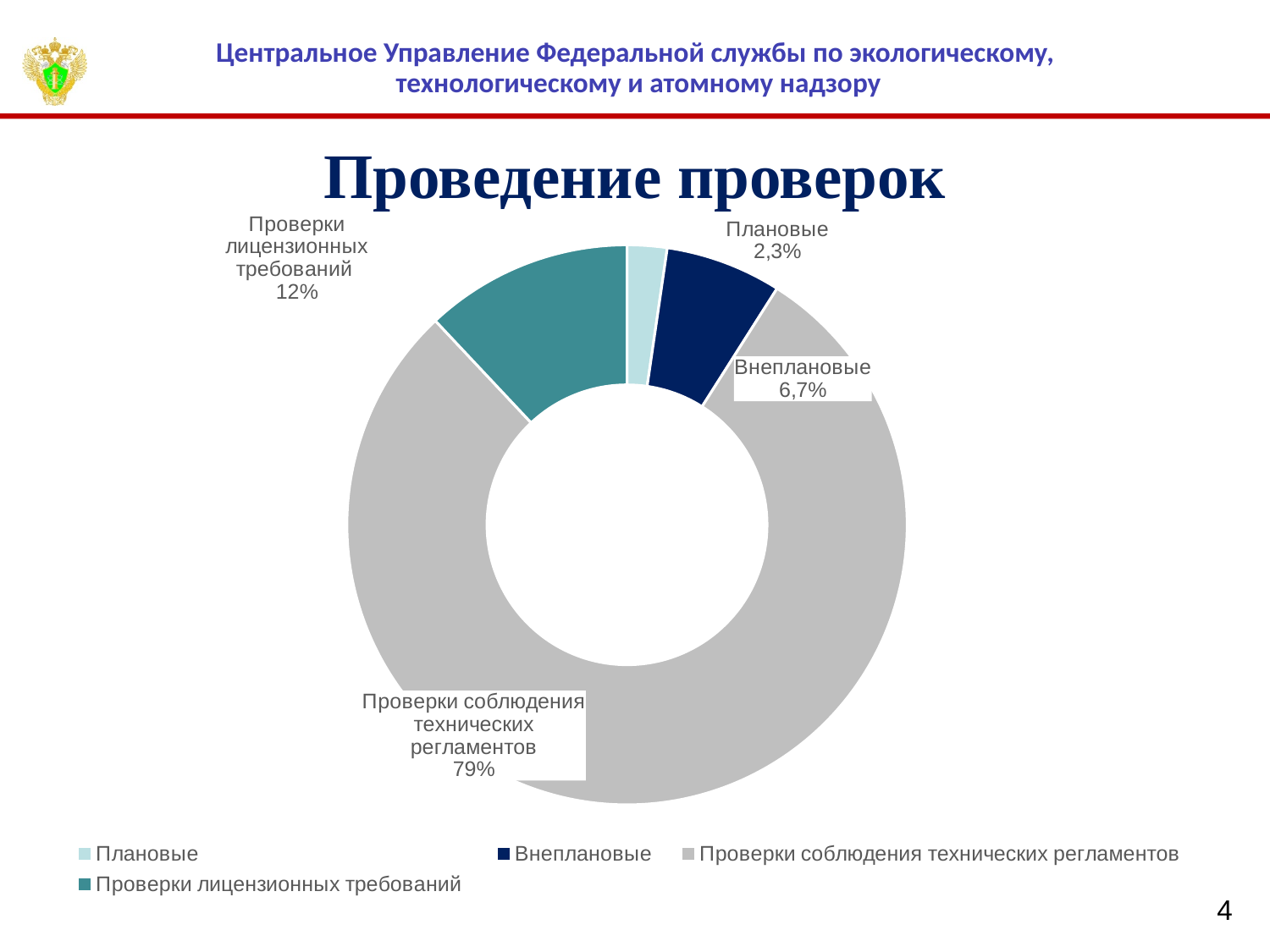
What is the difference between the values for 'Внеплановые' and 'Плановые'? 4,4% What is the title of the chart? Проведение проверок What share of the chart does the slice 'Проверки соблюдения технических регламентов' represent? 79% How many categories are shown in the chart? 4 What kind of chart is shown on the slide? doughnut (pie) chart What is the difference between the values for 'Проверки соблюдения технических регламентов' and 'Проверки лицензионных требований'? 67% Which is larger, 'Внеплановые' or 'Плановые'? Внеплановые What is the value shown for 'Плановые'? 2,3% Which category has the largest slice? Проверки соблюдения технических регламентов Which category has the smallest slice? Плановые What is the value shown for 'Проверки лицензионных требований'? 12% What is the value shown for 'Внеплановые'? 6,7%